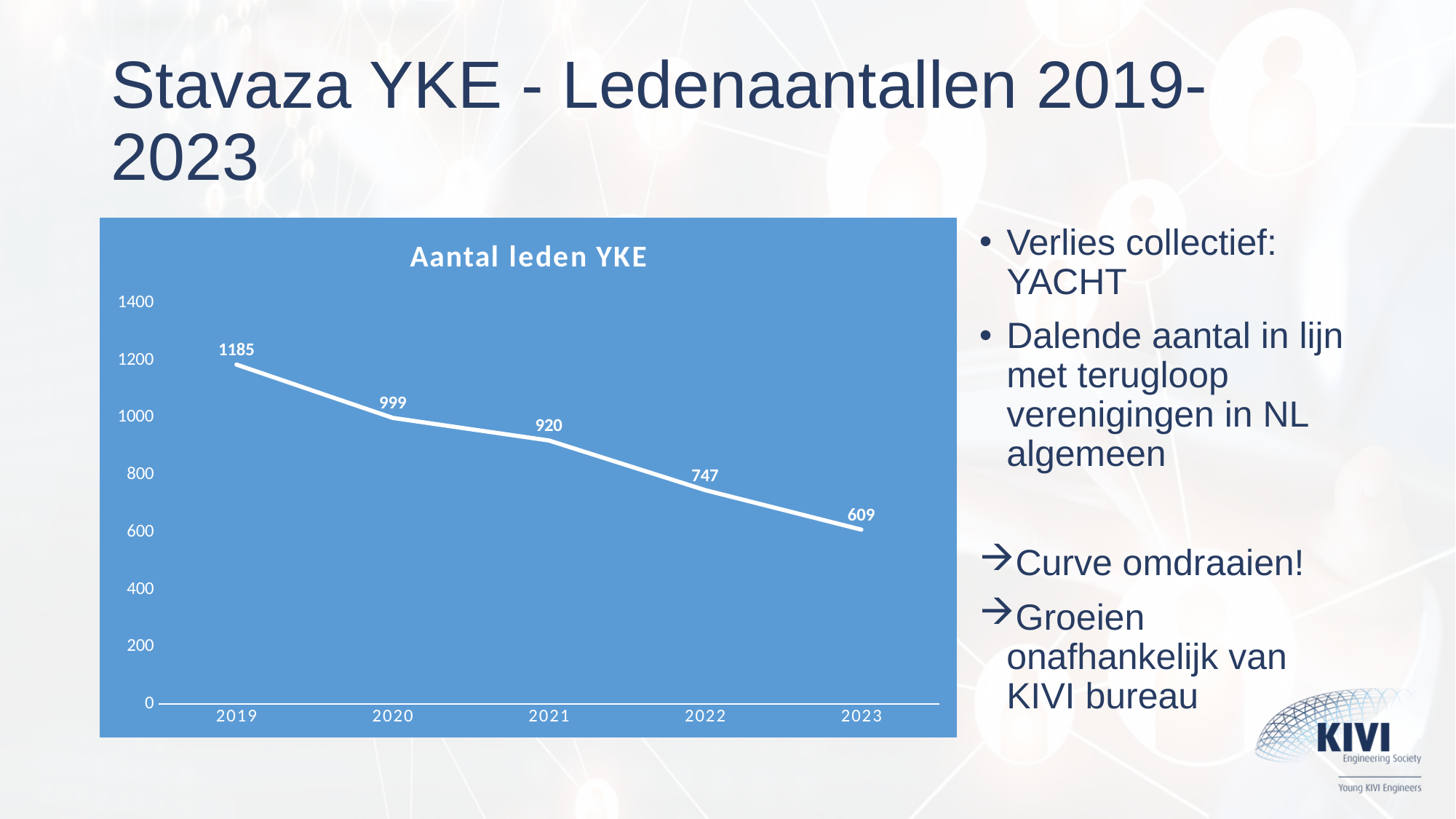
Which is larger, the value for 2020 or the value for 2022? 2020 Which year has the lowest number of members? 2023 What is the difference between the values for 2019 and 2023? 576 Which year has the highest number of members? 2019 What is the value for 2019 in the chart? 1185 What kind of chart is shown on the slide? line chart What is the difference between the values for 2020 and 2021? 79 Do the values rise or fall from 2019 to 2023? fall What is the value for 2021 in the chart? 920 How many years are plotted in the chart? 5 What is the value for 2023 in the chart? 609 Is the value for 2022 greater or less than 800? less